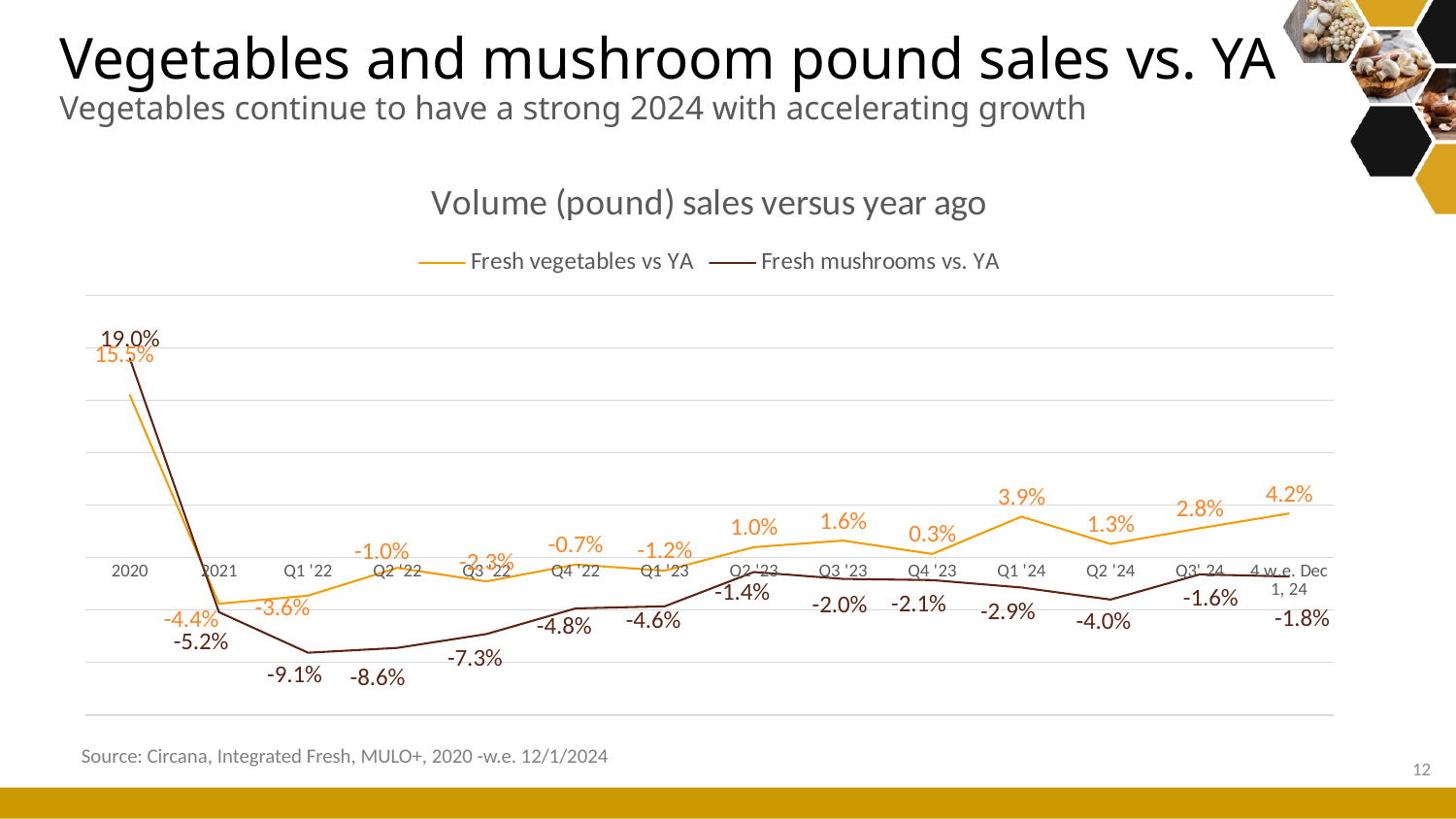
What kind of chart is shown on the slide? Line chart What is the Fresh mushrooms vs. YA value for Q1 '22? -9.1% What is the Fresh mushrooms vs. YA value for Q2 '24? -4.0% Which series has the higher value in Q3 '23, Fresh vegetables vs YA or Fresh mushrooms vs. YA? Fresh vegetables vs YA In which period is the Fresh vegetables vs YA value highest? 2020 How many series does the legend list? 2 How many time periods are plotted along the x axis? 14 What is the Fresh vegetables vs YA value for Q1 '24? 3.9% What is the title of the chart? Volume (pound) sales versus year ago What is the Fresh vegetables vs YA value for the 4 w.e. Dec 1, 24 period? 4.2% What is the difference between the Fresh vegetables vs YA and Fresh mushrooms vs. YA values in Q2 '24? 5.3 percentage points In which period is the Fresh mushrooms vs. YA value lowest? Q1 '22